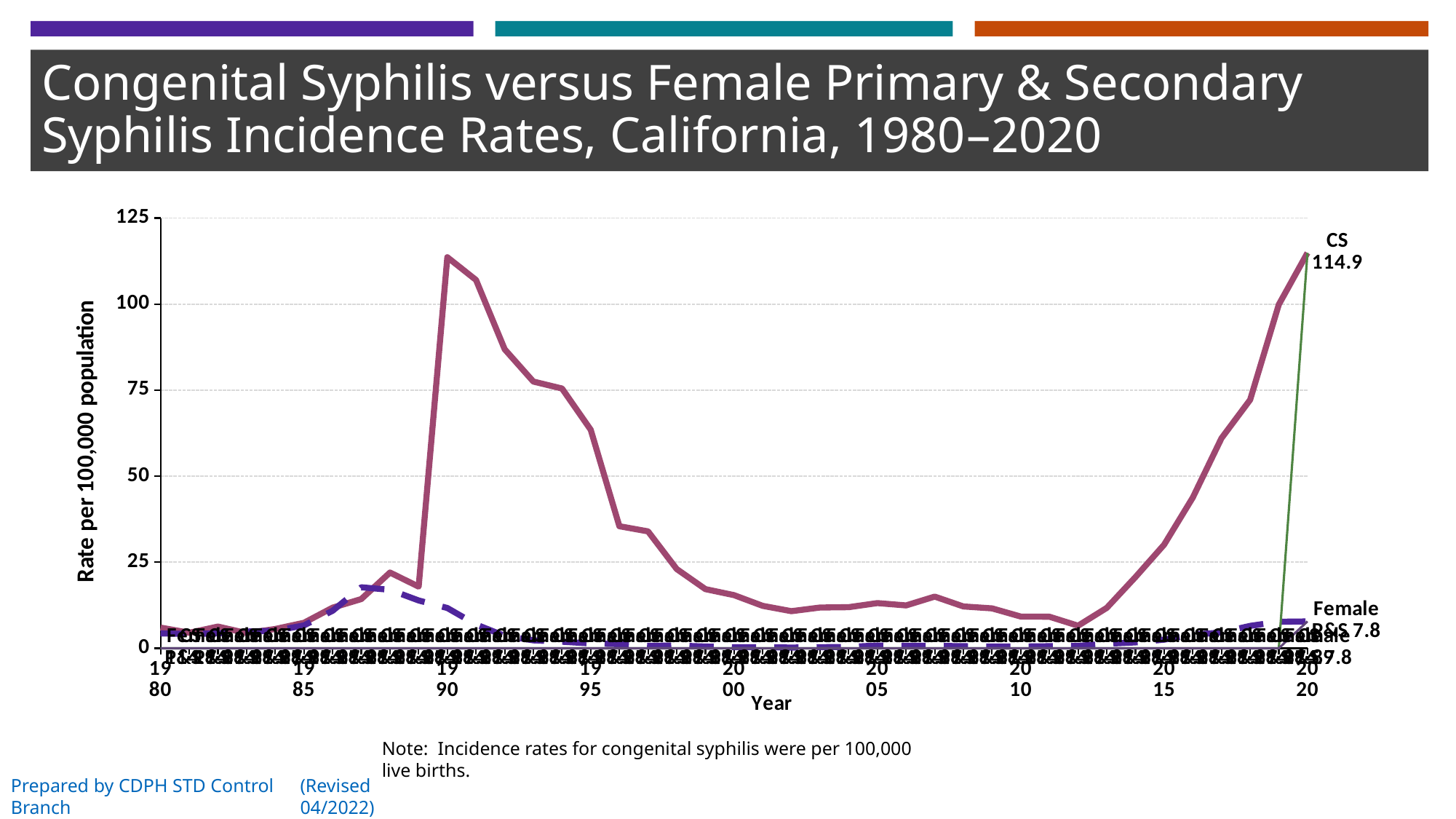
Is the CS rate in 2000 greater or less than 25? less Is the CS rate in 2018 greater or less than 50? greater What is the difference between the CS rate and the Female P&S rate in 2020? 107.1 What is the label of the y axis? Rate per 100,000 population Does the CS rate rise or fall between 1991 and 2000? fall In 2020, which series has the higher rate, CS or Female P&S? CS What is the CS rate in 2020? 114.9 What is the Female P&S rate in 2020? 7.8 How many data series are plotted on the chart? 2 What kind of chart is shown on the slide? line chart Is the CS rate in 1990 greater or less than 100? greater Does the CS rate rise or fall between 2012 and 2020? rise